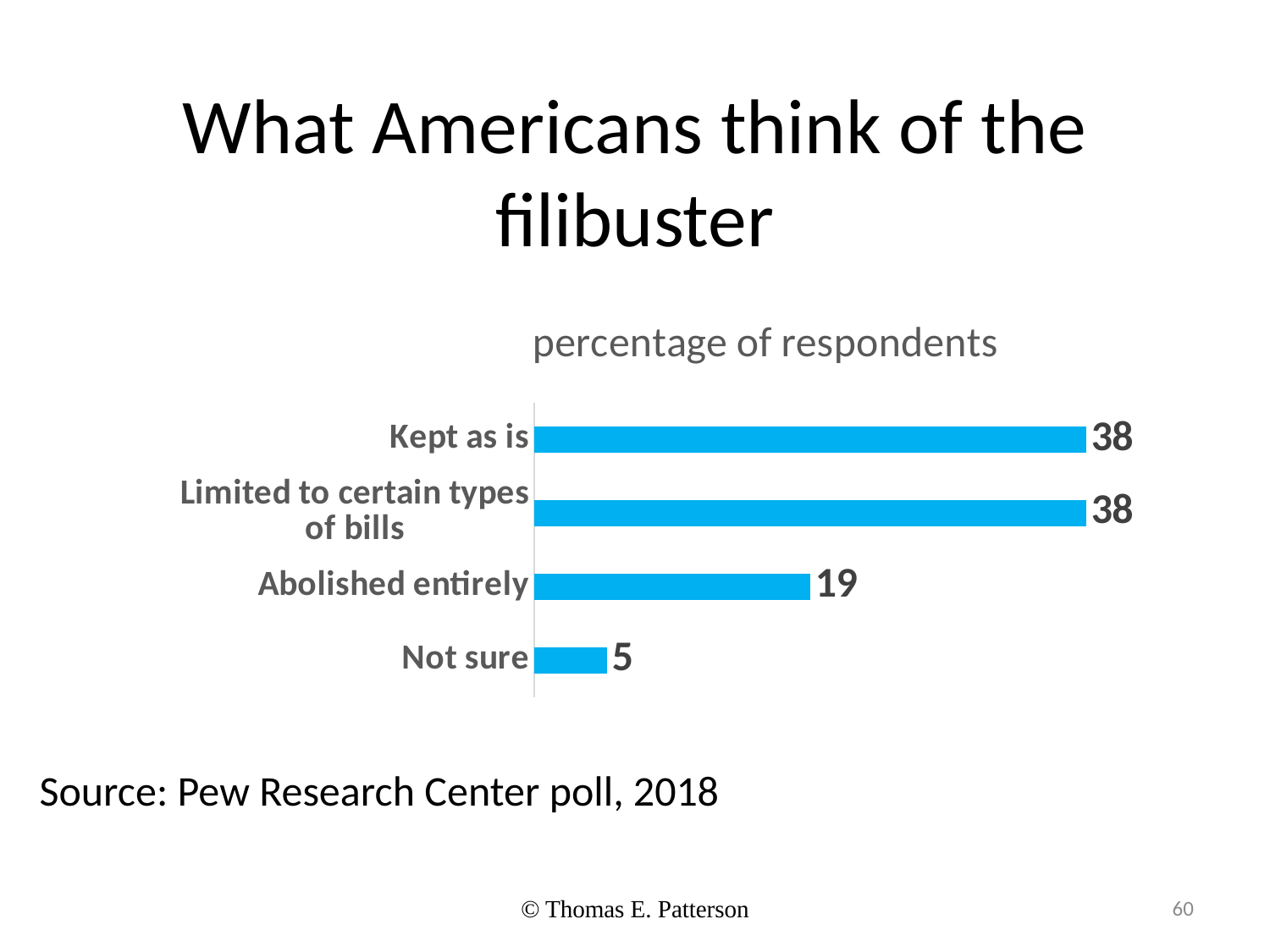
What percentage of respondents said the filibuster should be limited to certain types of bills? 38 What kind of chart is shown on the slide? Bar chart How many categories are shown in the chart? 4 Which is larger, the value for 'Abolished entirely' or the value for 'Not sure'? Abolished entirely What percentage of respondents said the filibuster should be kept as is? 38 What is the source of the data shown in the chart? Pew Research Center poll, 2018 What percentage of respondents said the filibuster should be abolished entirely? 19 Which category has the lowest percentage of respondents? Not sure What is the difference between the percentage for 'Abolished entirely' and 'Not sure'? 14 What is the difference between the percentage for 'Kept as is' and 'Abolished entirely'? 19 What percentage of respondents said they were not sure? 5 What is the title of the chart? percentage of respondents